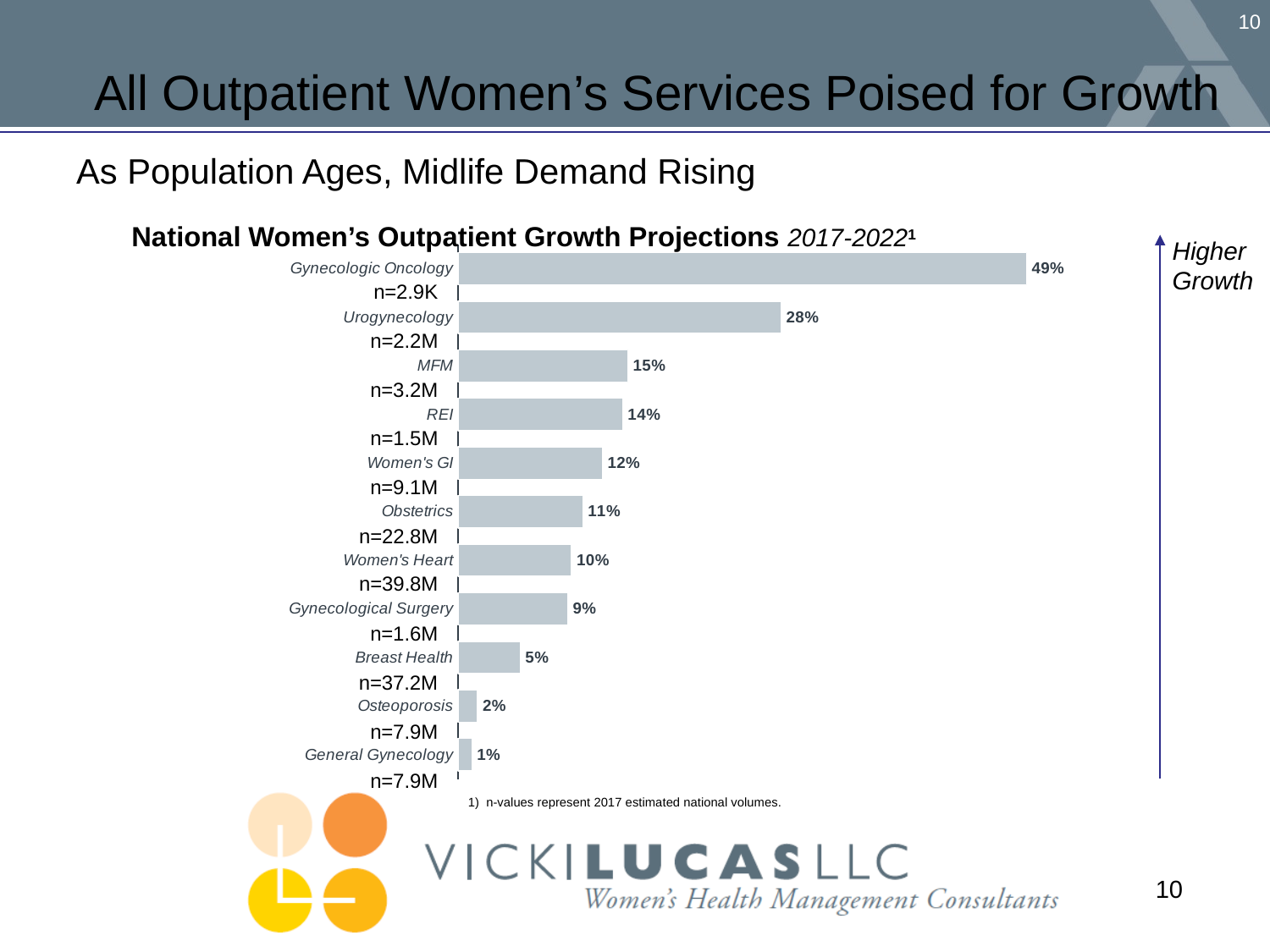
What is the projected growth for Urogynecology? 28% What is the difference in projected growth between MFM and REI? 1% What is the title of the chart? National Women's Outpatient Growth Projections 2017-2022 What kind of chart is shown on the slide? Bar chart Which service has the lowest projected growth? General Gynecology Which has a higher projected growth, Obstetrics or Women's Heart? Obstetrics What is the projected growth for Women's GI? 12% What is the difference in projected growth between Gynecologic Oncology and Urogynecology? 21% What is the projected growth for Breast Health? 5% Which service has the highest projected growth? Gynecologic Oncology How many services are shown in the chart? 11 What is the projected growth for Gynecologic Oncology? 49%